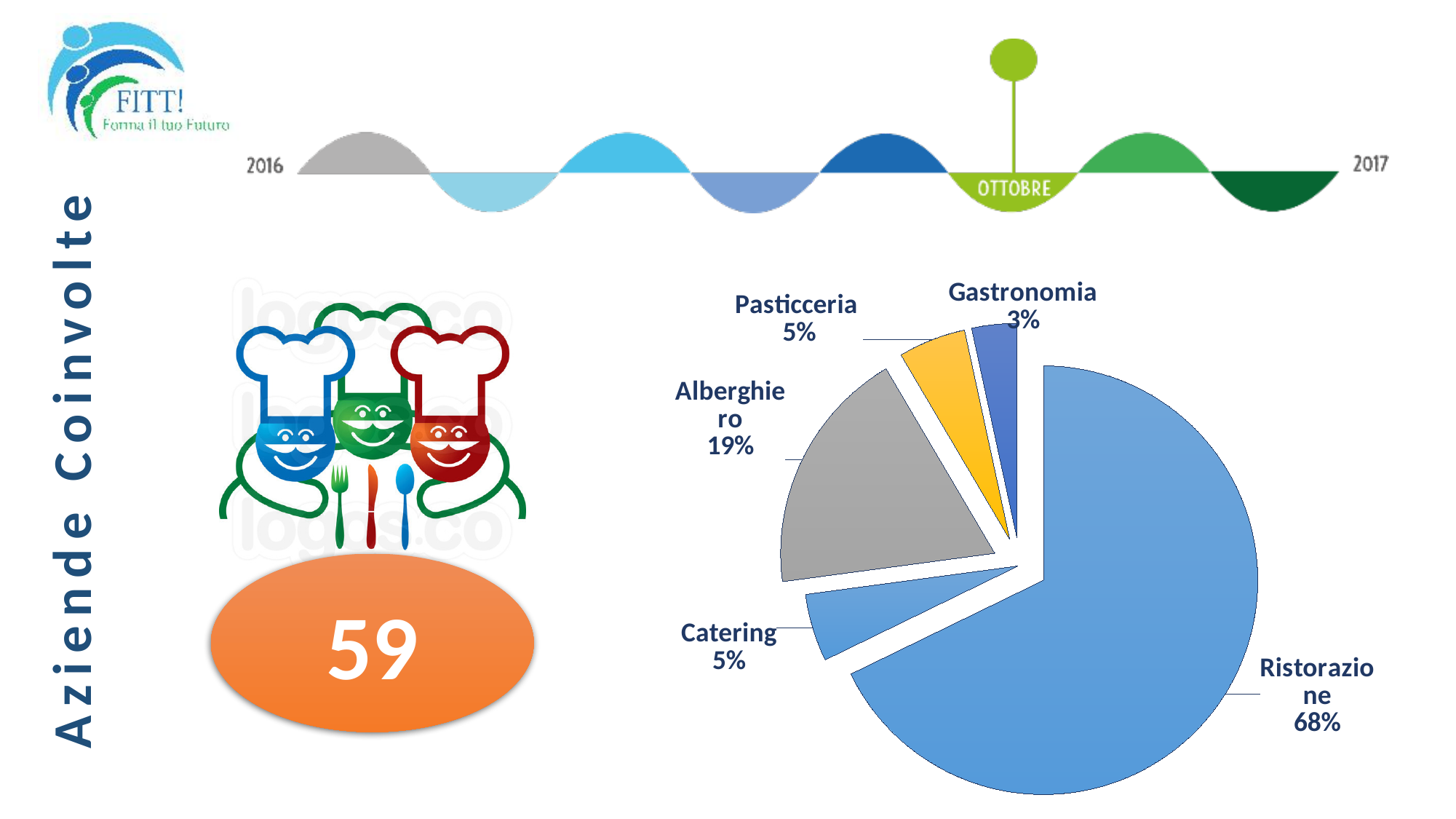
Which category has the smallest slice of the pie? Gastronomia Which category has the largest slice of the pie? Ristorazione How many slices does the pie chart have? 5 What is the difference in percentage points between Ristorazione and Alberghiero? 49 What colour is the Ristorazione slice of the pie? blue What share of the pie does Gastronomia have? 3% Which is larger, the share for Alberghiero or the share for Pasticceria? Alberghiero What is the difference in percentage points between Pasticceria and Gastronomia? 2 What share of the pie does Ristorazione have? 68% What kind of chart is shown on the slide? pie chart What share of the pie does Catering have? 5% What share of the pie does Alberghiero have? 19%